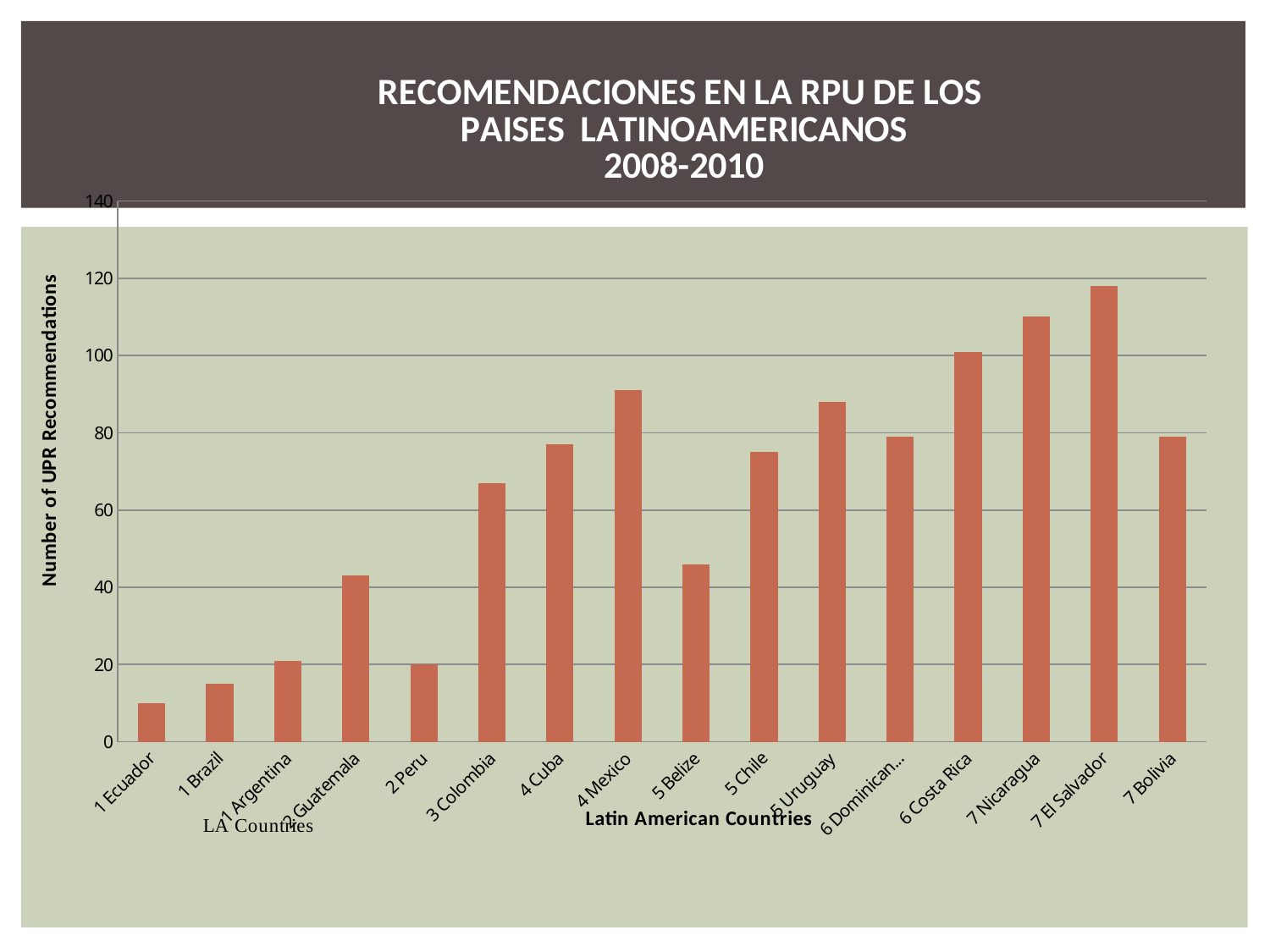
What is the title of the horizontal axis? Latin American Countries Is the value for 7 El Salvador greater or less than 100? greater Is the value for 4 Mexico greater or less than 80? greater What is the title of the vertical axis? Number of UPR Recommendations Which has more UPR recommendations, 4 Mexico or 4 Cuba? 4 Mexico Which country has the highest number of UPR recommendations? 7 El Salvador Is the value for 2 Guatemala greater or less than 60? less Which country has the lowest number of UPR recommendations? 1 Ecuador How many countries are shown on the x axis? 16 What kind of chart is shown on the slide? bar chart Which has more UPR recommendations, 7 Nicaragua or 6 Costa Rica? 7 Nicaragua